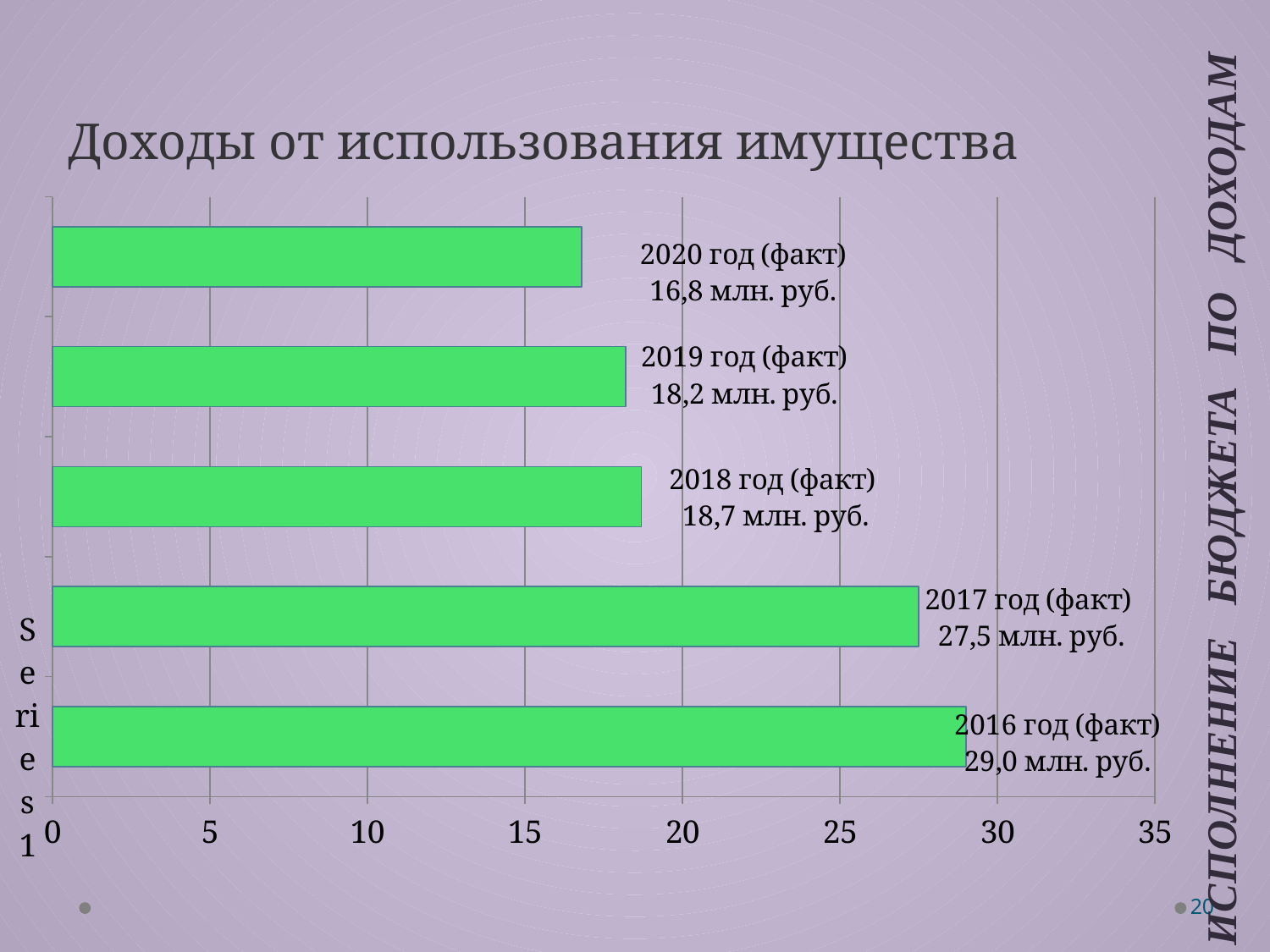
How many bars are shown in the chart? 5 Is the value for 2016 год (факт) greater or less than 25? greater What is the difference between the values for 2018 год (факт) and 2019 год (факт)? 0,5 млн. руб. What is the title of the chart? Доходы от использования имущества What is the value for 2017 год (факт)? 27,5 млн. руб. What is the difference between the values for 2016 год (факт) and 2020 год (факт)? 12,2 млн. руб. What is the value for 2020 год (факт)? 16,8 млн. руб. Which year has the lowest value? 2020 год (факт) What is the value for 2018 год (факт)? 18,7 млн. руб. What kind of chart is shown on the slide? bar chart Which is larger, the value for 2017 год (факт) or 2019 год (факт)? 2017 год (факт) Which year has the highest value? 2016 год (факт)